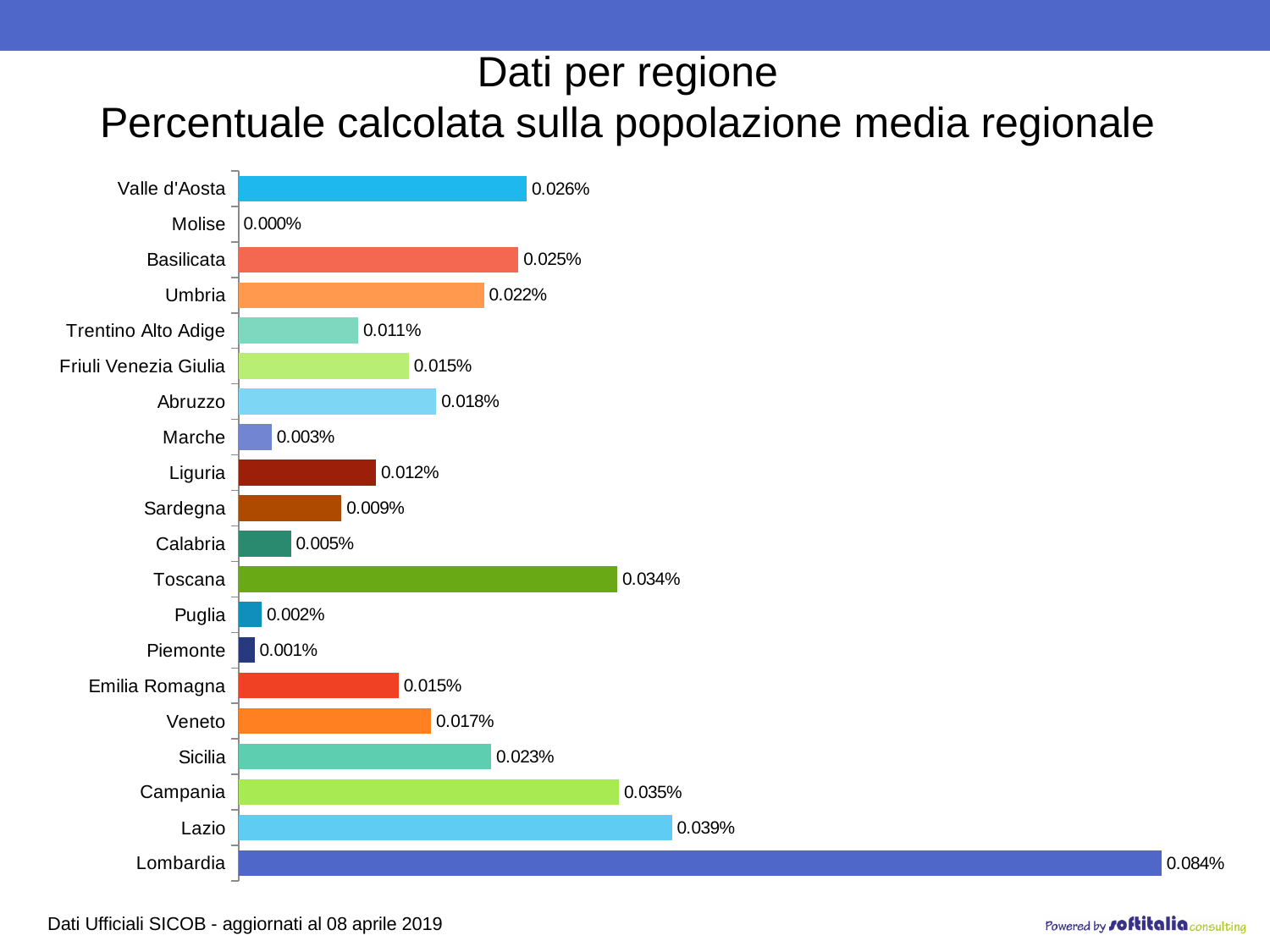
What kind of chart is shown on the slide? Bar chart Which has a larger value, Marche or Calabria? Calabria What is the value for Friuli Venezia Giulia? 0.015% What is the value for Lombardia? 0.084% Which region has the highest value? Lombardia Which region has the lowest value? Molise What is the difference between the values for Campania and Toscana? 0.001% Which has a larger value, Basilicata or Umbria? Basilicata What is the difference between the values for Lombardia and Lazio? 0.045% What is the value for Sardegna? 0.009% How many regions are shown in the chart? 20 What is the value for Toscana? 0.034%